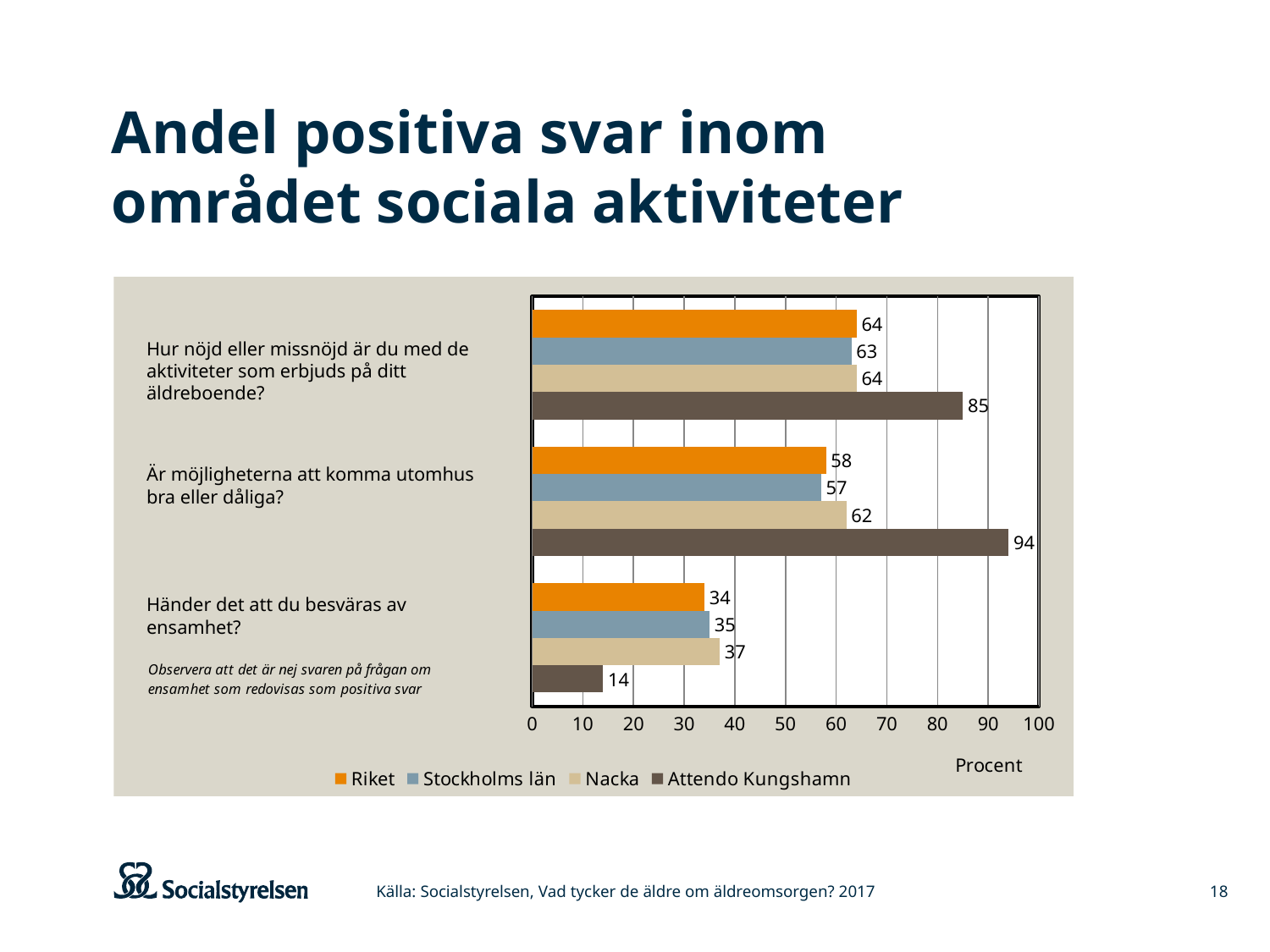
What is the difference between Attendo Kungshamn and Riket on the question "Är möjligheterna att komma utomhus bra eller dåliga?"? 36 What is the value for Stockholms län on the question "Hur nöjd eller missnöjd är du med de aktiviteter som erbjuds på ditt äldreboende?"? 63 What is the value for Attendo Kungshamn on the question "Är möjligheterna att komma utomhus bra eller dåliga?"? 94 What is the label on the horizontal axis of the chart? Procent Which series has the highest value on the question "Hur nöjd eller missnöjd är du med de aktiviteter som erbjuds på ditt äldreboende?"? Attendo Kungshamn Which series has the lowest value on the question "Händer det att du besväras av ensamhet?"? Attendo Kungshamn How many series does the legend list? 4 What is the value for Riket on the question "Händer det att du besväras av ensamhet?"? 34 Which is larger on the question "Händer det att du besväras av ensamhet?": Nacka or Stockholms län? Nacka What kind of chart is shown on the slide? Bar chart What is the value for Nacka on the question "Är möjligheterna att komma utomhus bra eller dåliga?"? 62 How many questions (categories) are shown on the chart? 3